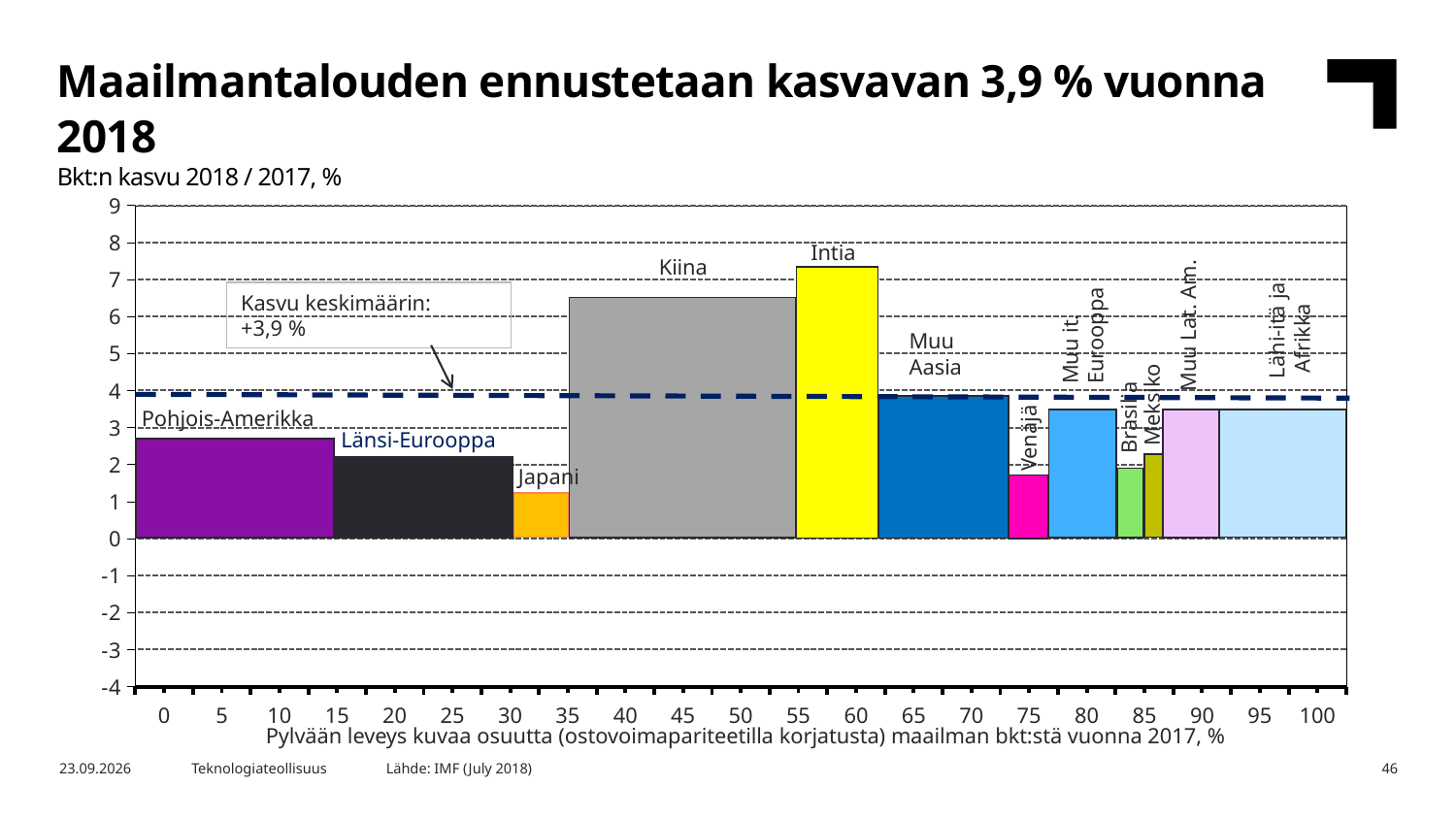
What kind of chart is shown on the slide? bar chart What average growth value is given in the annotation box on the chart? +3,9 % Which has the higher growth value, Kiina or Intia? Intia Is the value for Japani greater or less than 2? less Which region has the highest GDP growth in the chart? Intia Is the value for Kiina greater or less than 6? greater According to the note below the x axis, what does the width of each bar represent? Share of world GDP in 2017 (PPP-adjusted) How many regions are plotted as bars in the chart? 12 Which region has the lowest GDP growth in the chart? Japani Is the value for Lähi-itä ja Afrikka greater or less than 4? less Which has the higher growth value, Pohjois-Amerikka or Länsi-Eurooppa? Pohjois-Amerikka